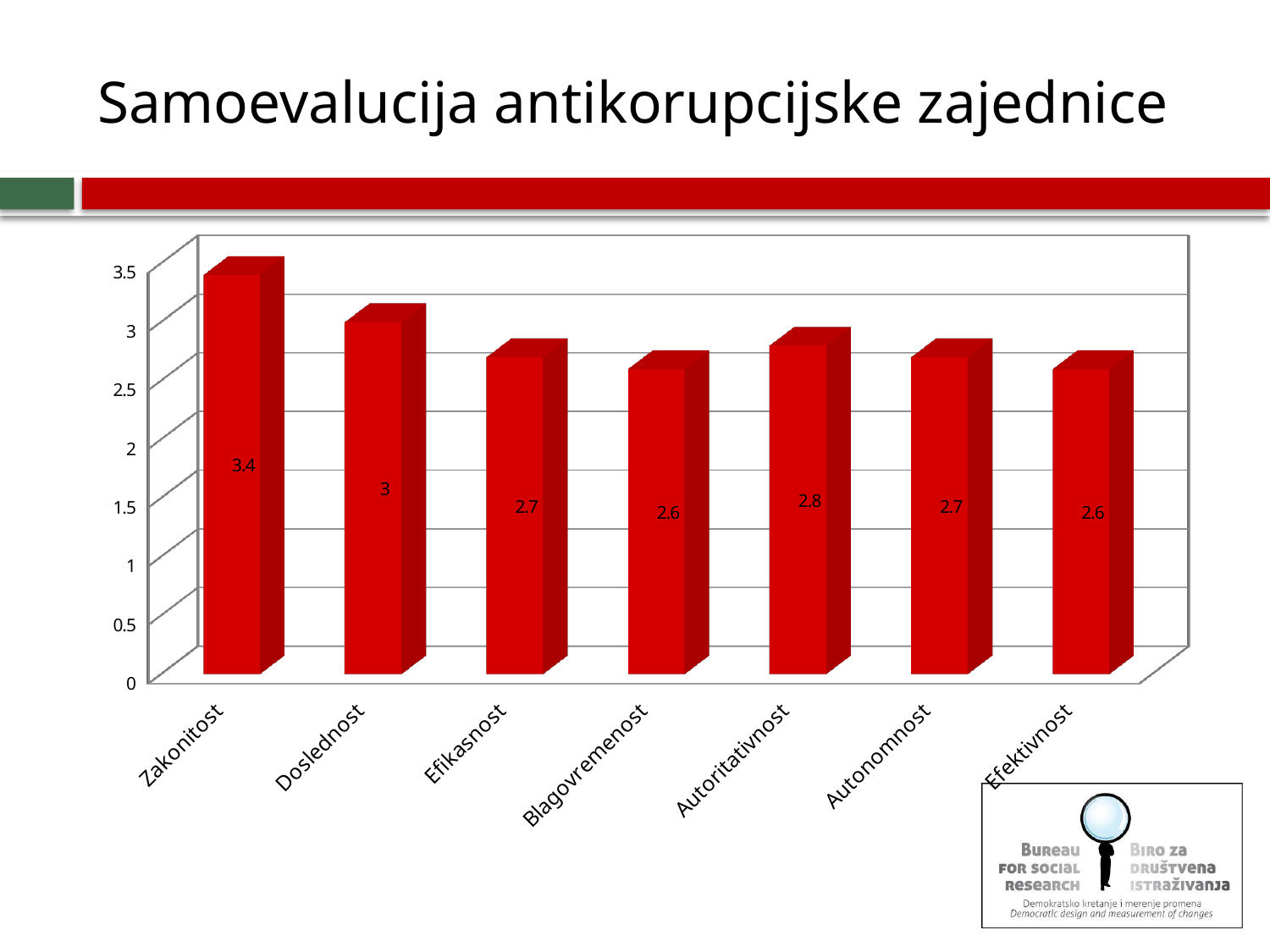
Which is larger, the value for Doslednost or the value for Efikasnost? Doslednost How many categories are shown on the x axis? 7 What is the difference between the values for Zakonitost and Doslednost? 0.4 What is the difference between the values for Autoritativnost and Efektivnost? 0.2 What kind of chart is shown on the slide? bar chart What is the value for Blagovremenost? 2.6 What is the value for Zakonitost? 3.4 What is the value for Autoritativnost? 2.8 Which category has the highest value? Zakonitost What is the title of the slide containing the chart? Samoevalucija antikorupcijske zajednice Is the value for Autonomnost greater or less than 3? less What is the value for Doslednost? 3